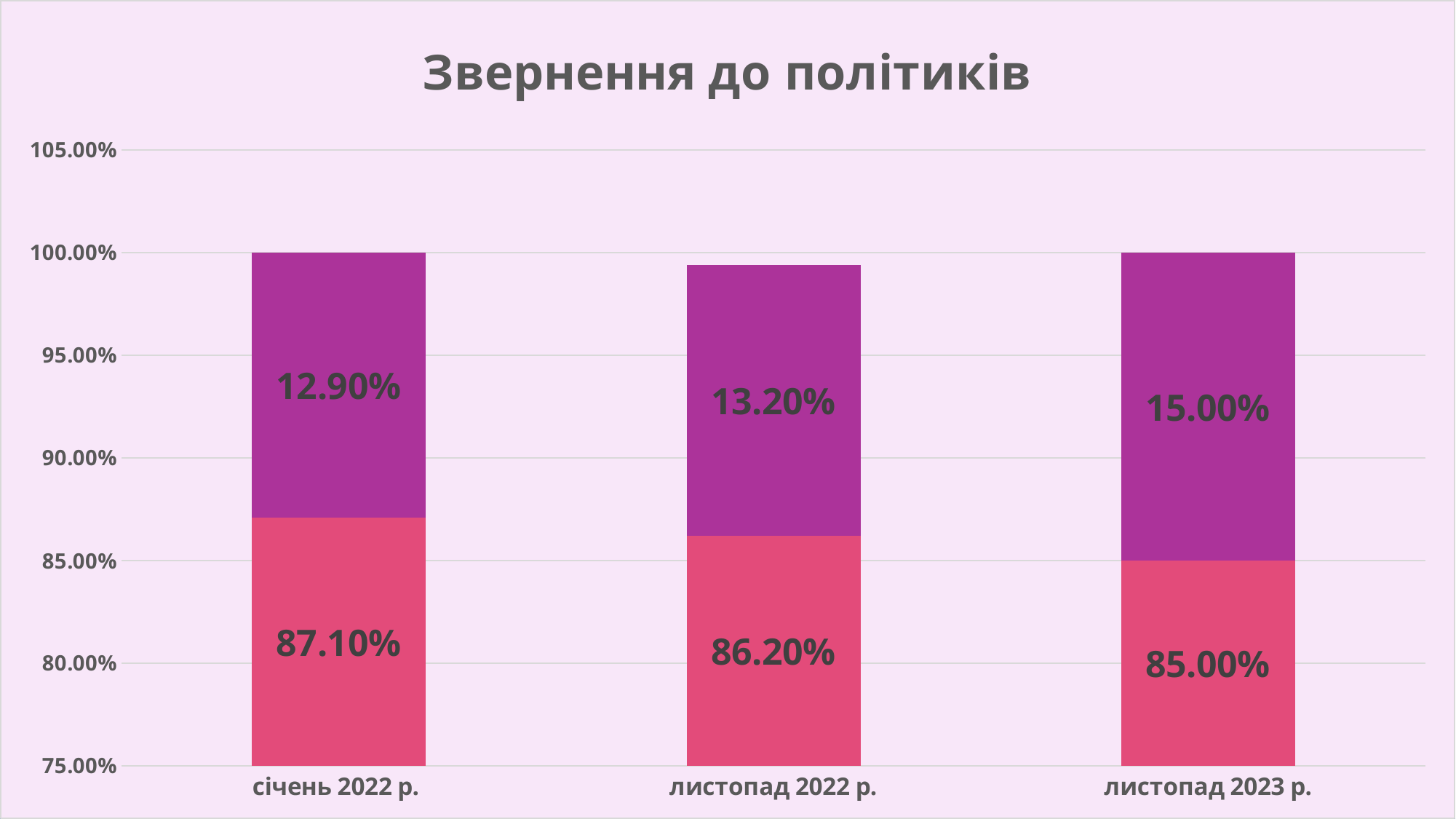
Which is larger: the purple (top) segment for січень 2022 р. or for листопад 2022 р.? листопад 2022 р. What is the value of the pink (bottom) segment for листопад 2023 р.? 85.00% What is the difference between the pink (bottom) segment values for січень 2022 р. and листопад 2023 р.? 2.10% What is the total of the stacked bar for листопад 2022 р.? 99.40% Do the values of the pink (bottom) segment rise or fall from січень 2022 р. to листопад 2023 р.? Fall What is the value of the pink (bottom) segment for січень 2022 р.? 87.10% Which category has the lowest value for the pink (bottom) segment? листопад 2023 р. What is the value of the purple (top) segment for листопад 2022 р.? 13.20% What is the title of the chart? Звернення до політиків What type of chart is shown on the slide? Stacked bar chart Which category has the highest value for the purple (top) segment? листопад 2023 р. How many categories are shown on the x axis? 3